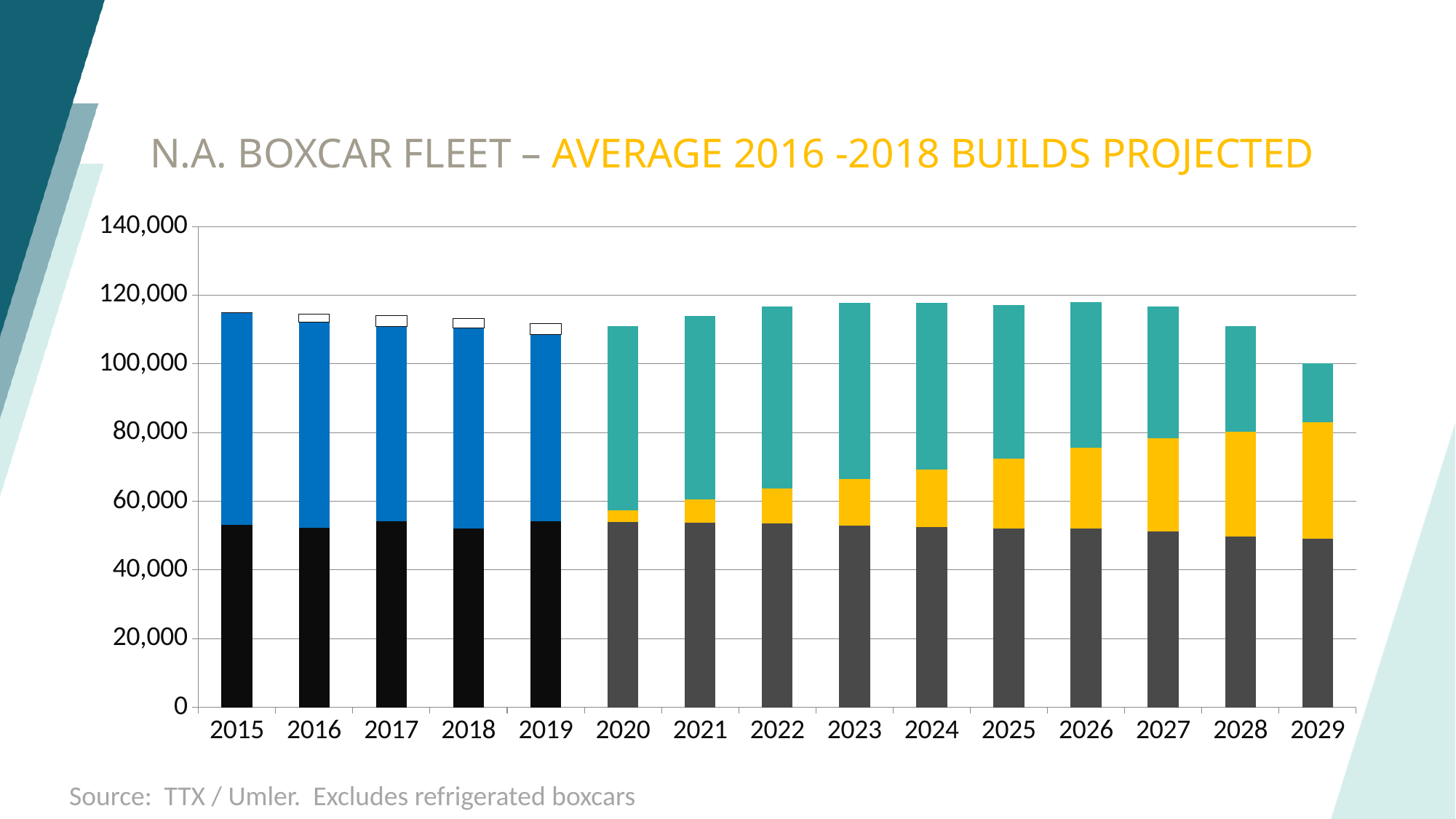
Which year has the lowest total bar in the chart? 2029 What kind of chart is shown on the slide? Stacked bar chart Which year has the larger total bar, 2015 or 2029? 2015 Do the total bars rise or fall from 2026 to 2029? fall How many years are shown along the x axis of the chart? 15 Does the yellow segment rise or fall from 2020 to 2029? rise Which year has the larger total bar, 2028 or 2029? 2028 Is the bottom (dark) segment of the 2020 bar greater or less than 40,000? greater Is the total bar for 2028 greater or less than 120,000? less What is the title of the chart on the slide? N.A. BOXCAR FLEET – AVERAGE 2016 -2018 BUILDS PROJECTED Is the total bar for 2015 greater or less than 100,000? greater